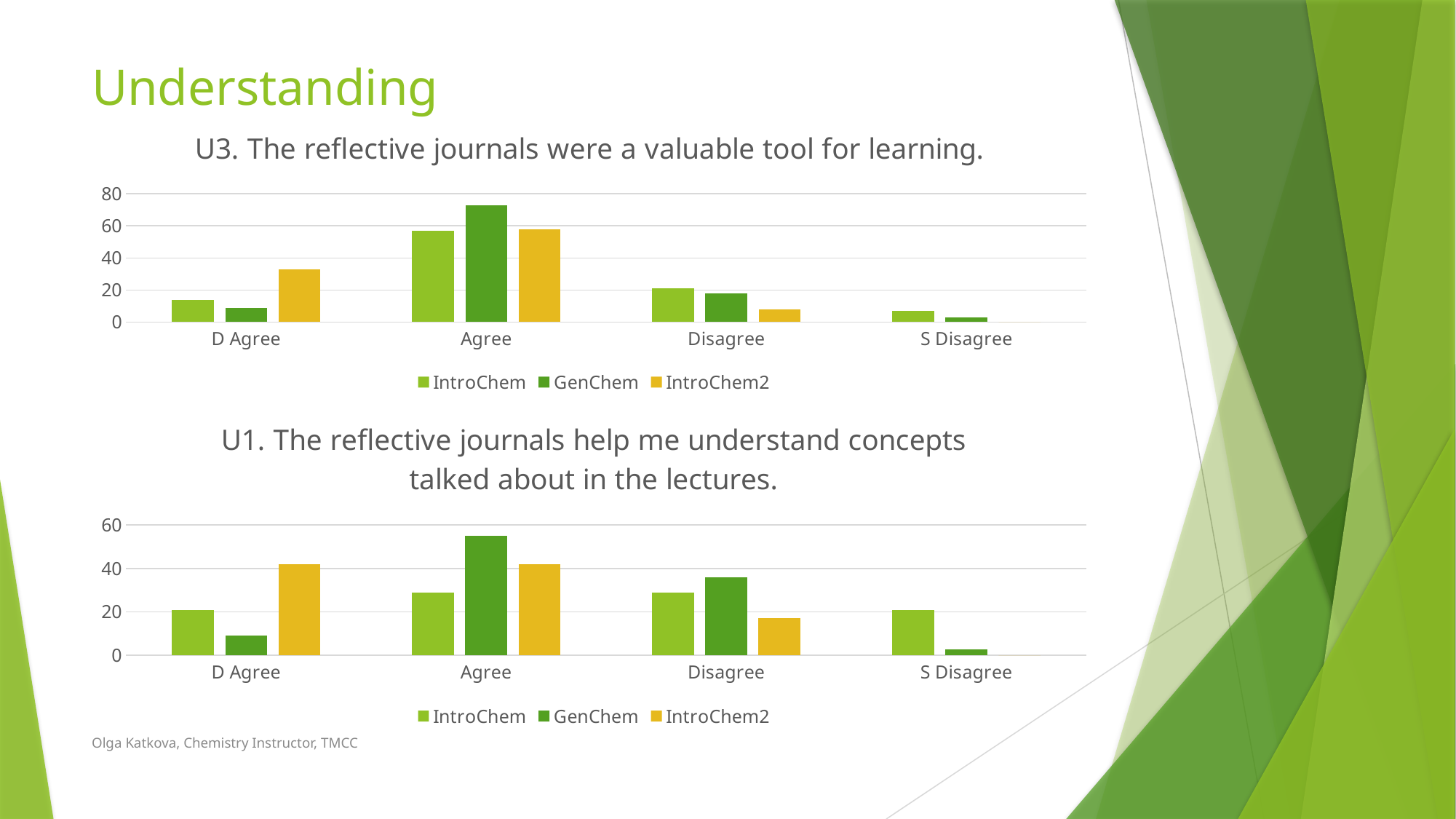
In the bottom chart (U1), is the GenChem value for Agree greater or less than 40? greater In the bottom chart (U1), for D Agree, which is larger: IntroChem or IntroChem2? IntroChem2 In the bottom chart (U1), for which category is the GenChem bar lowest? S Disagree In the top chart (U3), for which category is the GenChem bar highest? Agree In the top chart (U3), is the IntroChem2 value for D Agree greater or less than 40? less What are the three legend entries of the bottom chart (U1)? IntroChem, GenChem, IntroChem2 In the bottom chart (U1), which series has the highest value for Agree? GenChem How many categories are shown on the x axis of the bottom chart (U1)? 4 What kind of chart is the chart titled "U3. The reflective journals were a valuable tool for learning."? bar chart In the top chart (U3), is the GenChem value for Agree greater or less than 60? greater How many series does the legend of the top chart (U3) list? 3 In the top chart (U3), for D Agree, which is larger: IntroChem2 or GenChem? IntroChem2